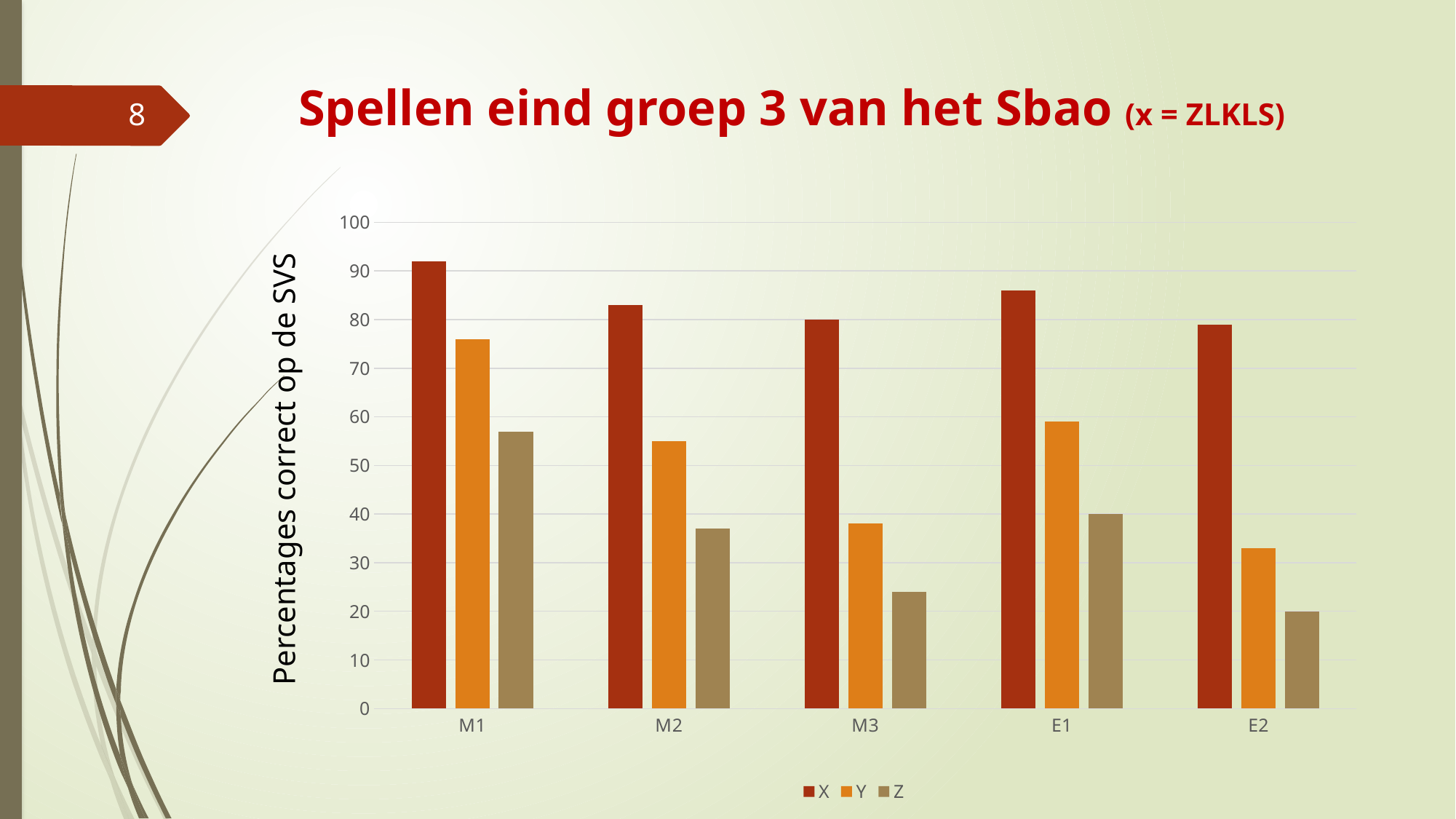
Is the value for Z at M3 greater or less than 30? less Is the value for X at M1 greater or less than 80? greater What kind of chart is shown on the slide? bar chart Is the value for X at E1 greater or less than 80? greater Which is larger: the value for Y at M1 or the value for Y at M2? Y at M1 Which category has the highest value for series X? M1 How many categories are shown on the x axis? 5 How many series does the legend list? 3 Which category has the lowest value for series Y? E2 Which category has the lowest value for series Z? E2 What is the label of the vertical axis? Percentages correct op de SVS